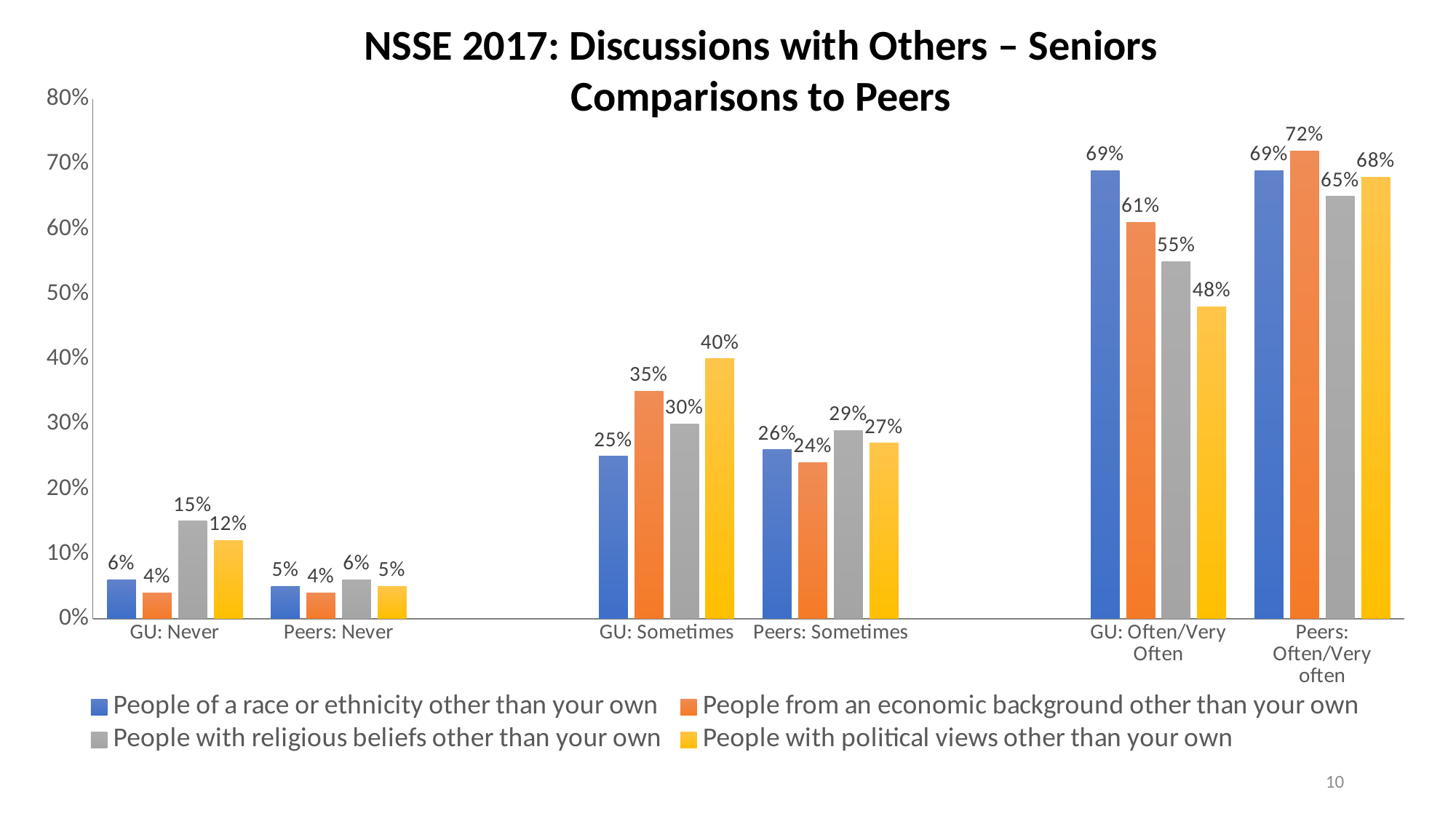
What is the value for 'People with political views other than your own' in the GU: Sometimes category? 40% What is the title of the chart? NSSE 2017: Discussions with Others – Seniors Comparisons to Peers What kind of chart is shown on the slide? bar chart What is the value for 'People from an economic background other than your own' in the Peers: Often/Very often category? 72% Which is larger: the 'People with religious beliefs other than your own' value for GU: Sometimes or for Peers: Sometimes? GU: Sometimes What is the difference between the 'People with political views other than your own' values for Peers: Often/Very often and GU: Often/Very Often? 20% How many series does the legend list? 4 How many categories are shown on the x axis? 6 What is the value for 'People with religious beliefs other than your own' in the GU: Never category? 15% Which series has the lowest value in the GU: Often/Very Often category? People with political views other than your own Which series has the highest value in the Peers: Often/Very often category? People from an economic background other than your own What is the difference between the 'People from an economic background other than your own' values for GU: Sometimes and Peers: Sometimes? 11%